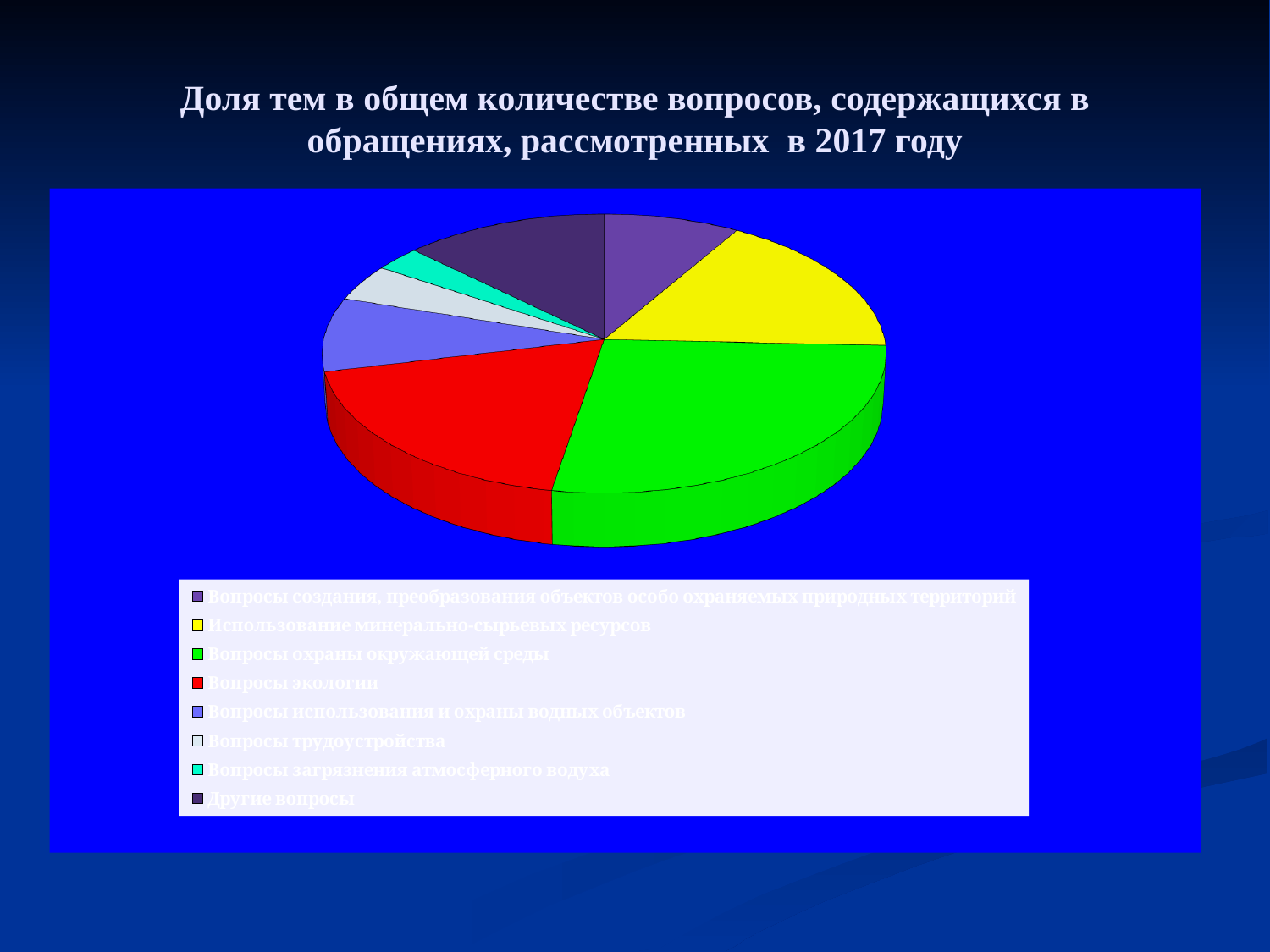
Which slice is larger: Другие вопросы or Вопросы загрязнения атмосферного воздуха? Другие вопросы What is the title of the chart on the slide? Доля тем в общем количестве вопросов, содержащихся в обращениях, рассмотренных в 2017 году How many categories (slices) does the pie chart have? 8 Which category has the largest slice of the pie? Вопросы охраны окружающей среды Which slice is larger: Использование минерально-сырьевых ресурсов or Вопросы трудоустройства? Использование минерально-сырьевых ресурсов What kind of chart is shown on the slide? pie chart Which slice is larger: Вопросы охраны окружающей среды or Вопросы экологии? Вопросы охраны окружающей среды Which colour represents Вопросы экологии in the pie chart? red